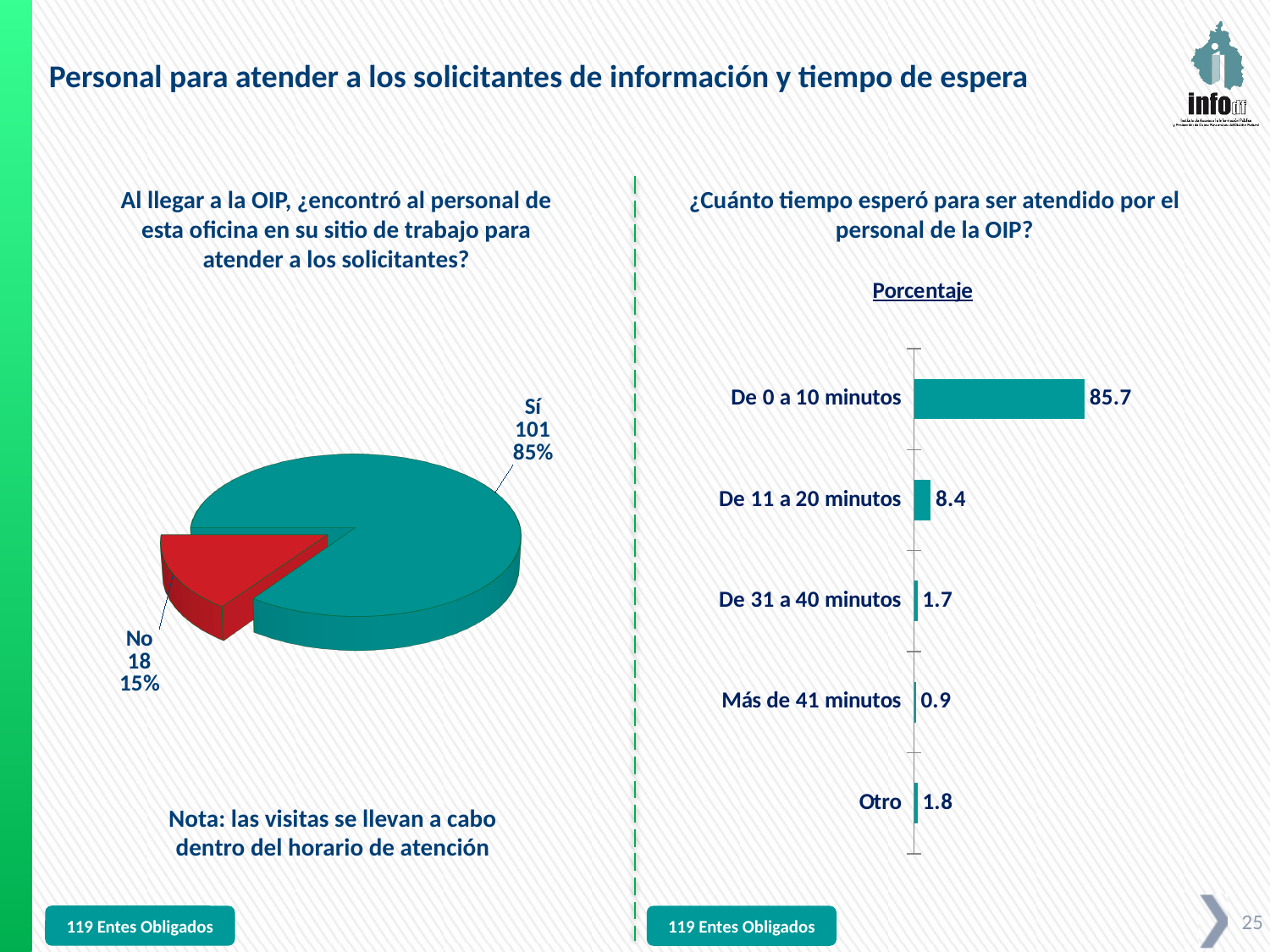
In the bar chart on the right, how many categories are shown? 5 In the bar chart on the right, which category has the lowest value? Más de 41 minutos In the pie chart on the left, what percentage of respondents answered 'Sí'? 85% What kind of chart is shown on the left side of the slide? Pie chart In the pie chart on the left, which slice is larger, 'Sí' or 'No'? Sí In the bar chart on the right, what is the difference between 'De 0 a 10 minutos' and 'De 11 a 20 minutos'? 77.3 In the pie chart on the left, what is the count for 'Sí'? 101 In the pie chart on the left, how many slices are there? 2 In the bar chart on the right, what is the value for 'De 0 a 10 minutos'? 85.7 In the bar chart on the right, which category has the highest value? De 0 a 10 minutos In the bar chart on the right, what is the value for 'Más de 41 minutos'? 0.9 In the pie chart on the left, how many respondents answered 'No'? 18